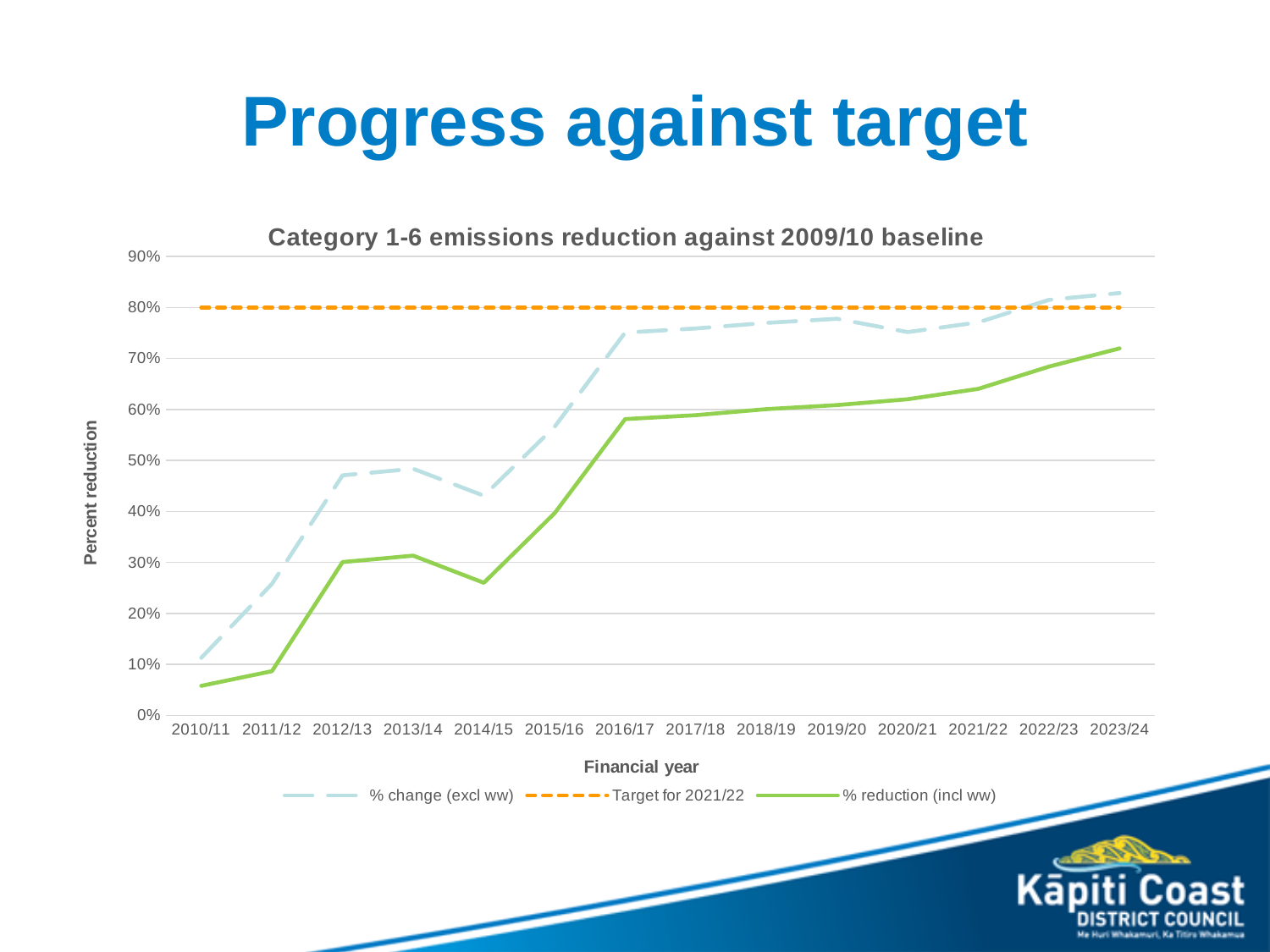
Is the value for '% reduction (incl ww)' in 2023/24 greater or less than 70%? greater What kind of chart is shown on the slide? Line chart In which financial year is '% reduction (incl ww)' lowest? 2010/11 What is the value of the 'Target for 2021/22' line? 80% In which financial year is '% reduction (incl ww)' highest? 2023/24 How many financial years are shown on the x axis? 14 Does '% reduction (incl ww)' generally rise or fall from 2010/11 to 2023/24? Rise In 2023/24, which is larger: '% change (excl ww)' or '% reduction (incl ww)'? % change (excl ww) How many series does the legend list? 3 Is the value for '% change (excl ww)' in 2020/21 greater or less than 80%? less What is the title of the chart? Category 1-6 emissions reduction against 2009/10 baseline Is the value for '% reduction (incl ww)' in 2014/15 greater or less than 30%? less